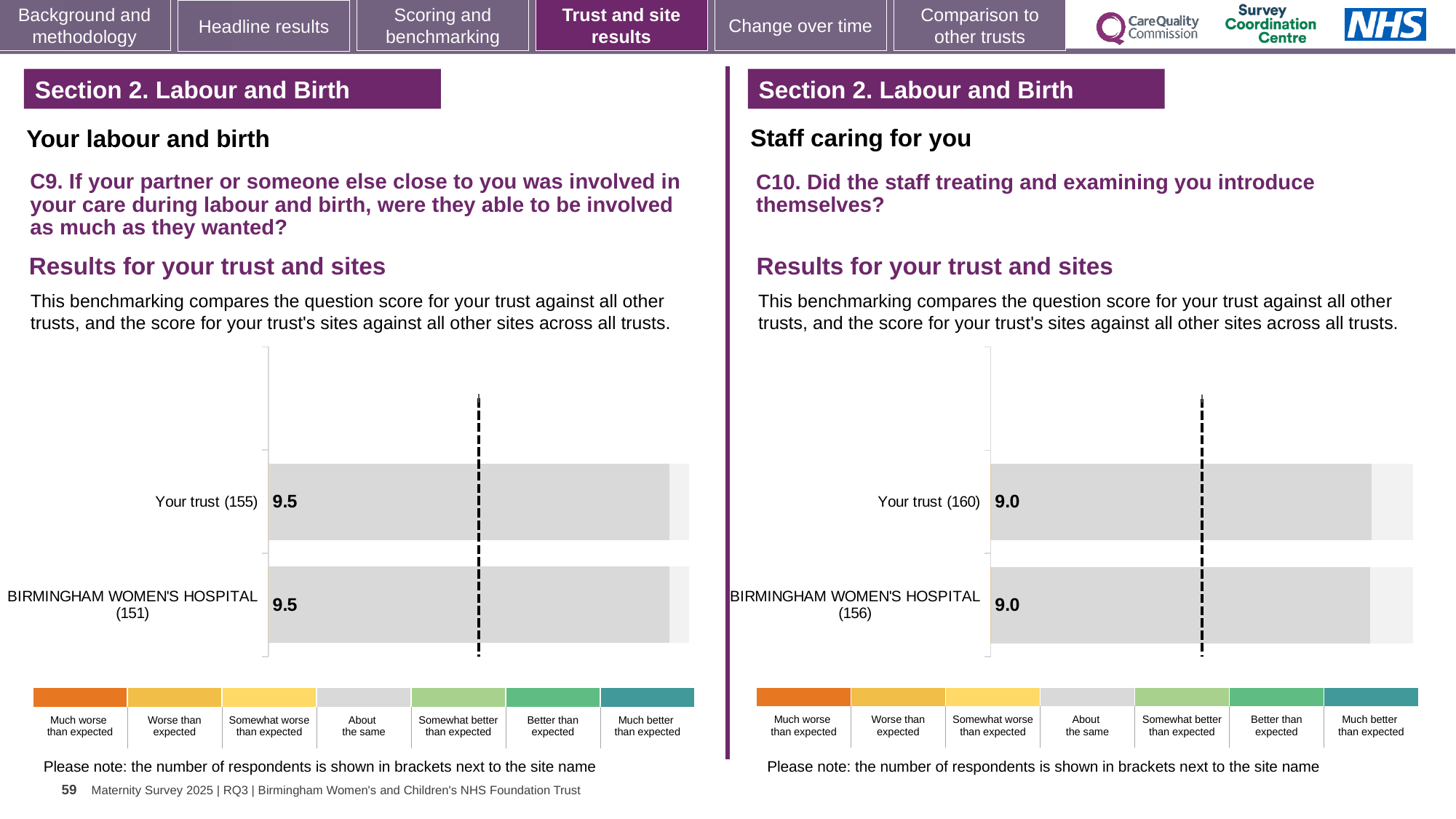
On the right chart (C10), how many respondents are shown in brackets for BIRMINGHAM WOMEN'S HOSPITAL? 156 On the left chart (C9), how many respondents are shown in brackets for Your trust? 155 On the right chart (C10), which category in the colour key is shown in orange at the far left? Much worse than expected On the right chart (C10), what is the score for Your trust? 9.0 On the left chart (C9), what is the difference between the score for Your trust and the score for BIRMINGHAM WOMEN'S HOSPITAL? 0.0 On the left chart (C9), how many respondents are shown in brackets for BIRMINGHAM WOMEN'S HOSPITAL? 151 How many categories does the colour key below the left chart (C9) list? 7 How many bars are plotted on the right chart (C10)? 2 On the left chart (C9), what is the score for BIRMINGHAM WOMEN'S HOSPITAL? 9.5 On the right chart (C10), what is the score for BIRMINGHAM WOMEN'S HOSPITAL? 9.0 On the left chart (C9), what is the score for Your trust? 9.5 What kind of chart is used on the left (C9) to show the results for your trust and sites? Bar chart